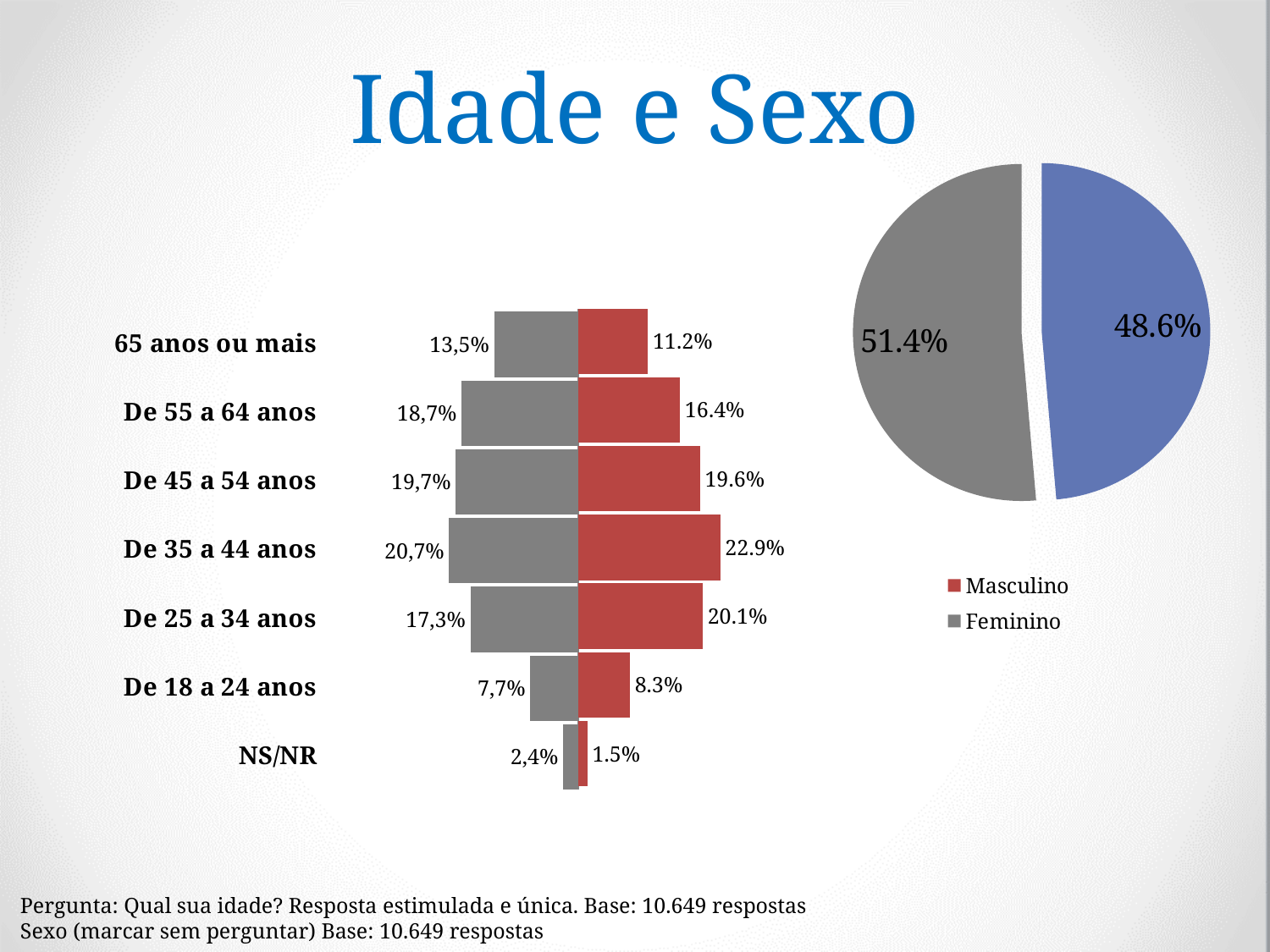
On the pie chart on the right, what is the difference between the grey slice and the blue slice? 2.8 percentage points On the bar chart on the left, what is the Masculino value for De 35 a 44 anos? 22.9% On the bar chart on the left, which age group has the lowest Feminino value? NS/NR On the bar chart on the left, what is the Feminino value for NS/NR? 2,4% On the bar chart on the left, what is the Feminino value for De 55 a 64 anos? 18,7% On the bar chart on the left, what is the difference between the Masculino and Feminino values for De 35 a 44 anos? 2.2 percentage points On the pie chart on the right, what is the value of the grey slice? 51.4% On the bar chart on the left, which age group has the highest Masculino value? De 35 a 44 anos What kind of chart is the chart on the left of the slide? Bar chart How many series does the legend list for the bar chart on the left? 2 How many age categories are shown on the bar chart on the left? 7 On the bar chart on the left, which is larger for De 25 a 34 anos: the Masculino value or the Feminino value? Masculino